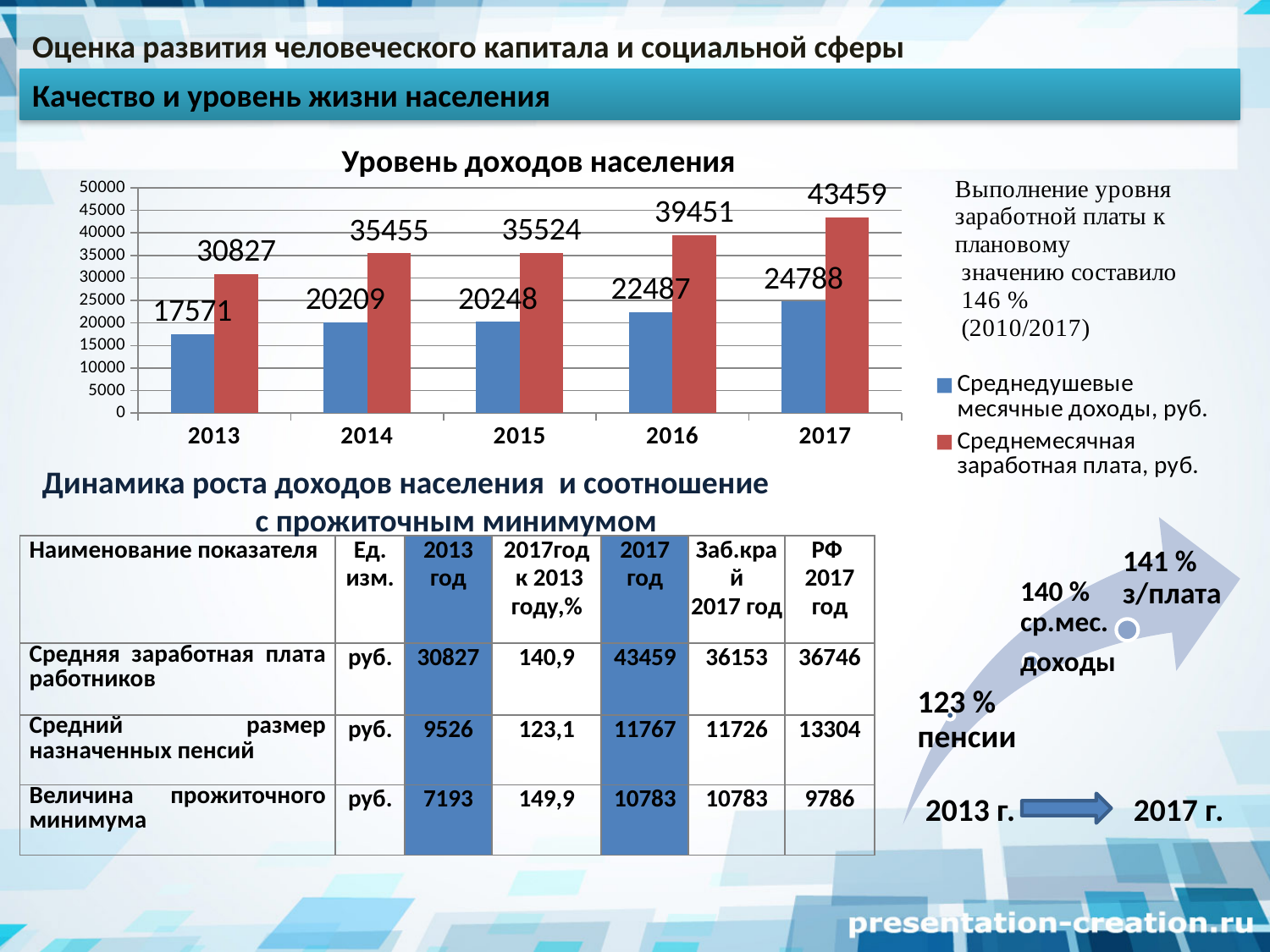
How many series does the legend of the "Уровень доходов населения" chart list? 2 What type of chart is shown under the title "Уровень доходов населения"? bar chart What is the value of "Среднемесячная заработная плата, руб." for 2017 in the chart? 43459 What is the value of "Среднедушевые месячные доходы, руб." for 2013 in the chart? 17571 Which is larger in 2016: "Среднедушевые месячные доходы, руб." or "Среднемесячная заработная плата, руб."? Среднемесячная заработная плата, руб. In which year is "Среднемесячная заработная плата, руб." lowest in the chart? 2013 What colour are the bars for "Среднемесячная заработная плата, руб." in the chart? red How many years are shown on the x axis of the "Уровень доходов населения" chart? 5 What is the difference between "Среднемесячная заработная плата, руб." and "Среднедушевые месячные доходы, руб." in 2017? 18671 Does "Среднемесячная заработная плата, руб." rise or fall from 2013 to 2017 in the chart? rise What is the value of "Среднемесячная заработная плата, руб." for 2015 in the chart? 35524 In which year is "Среднедушевые месячные доходы, руб." highest in the chart? 2017